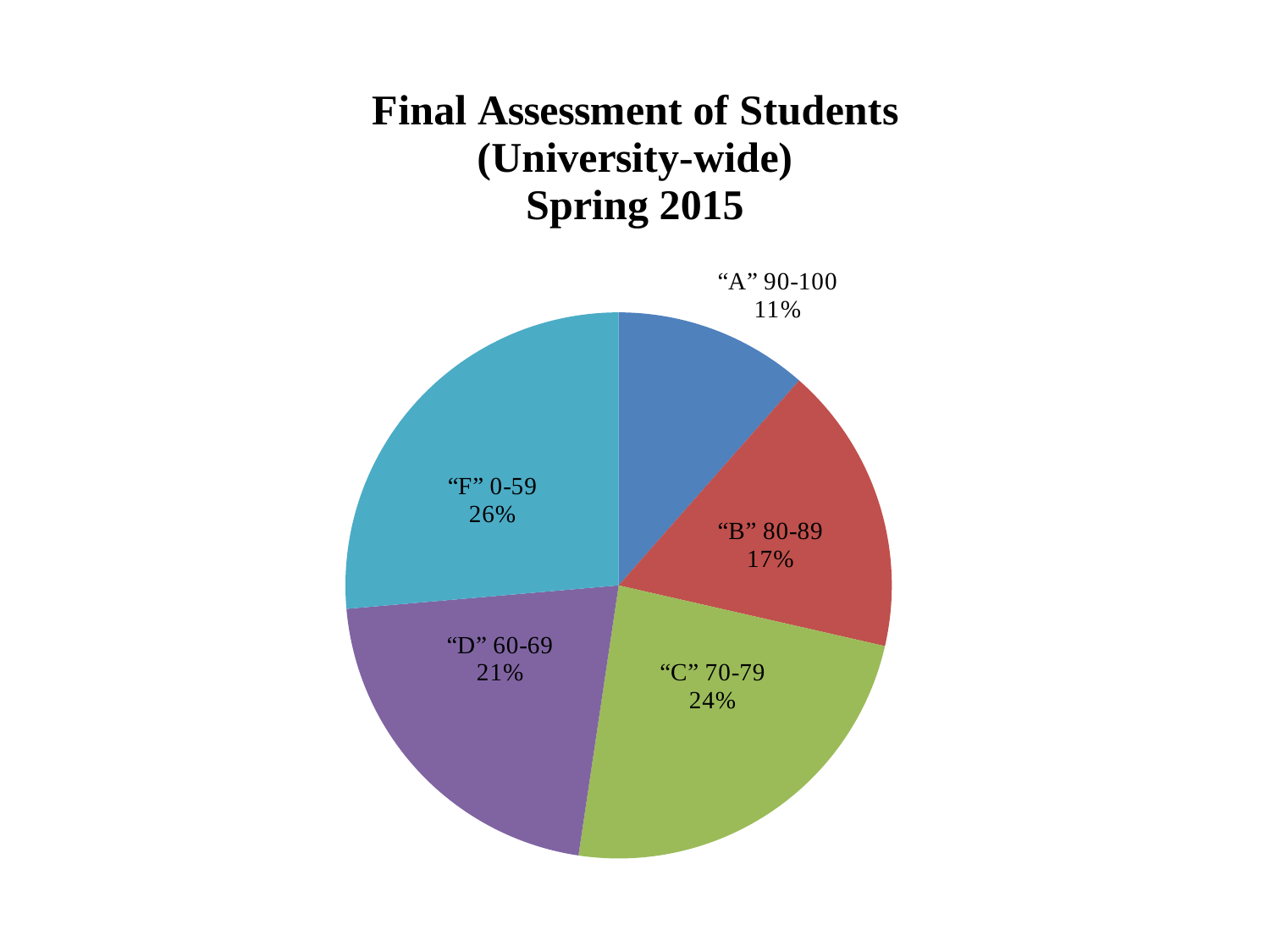
What percentage of students received an "F" (0-59)? 26% What percentage of students received a "C" (70-79)? 24% What percentage of students received a "D" (60-69)? 21% What is the title of the chart? Final Assessment of Students (University-wide) Spring 2015 Which is larger, the share of "C" 70-79 or the share of "D" 60-69? "C" 70-79 Which grade category has the smallest share of the pie? "A" 90-100 What is the difference in percentage points between the "F" share and the "A" share? 15 What percentage of students received a "B" (80-89)? 17% What kind of chart is shown on the slide? Pie chart How many grade categories are shown in the pie chart? 5 What percentage of students received an "A" (90-100)? 11% Which grade category has the largest share of the pie? "F" 0-59